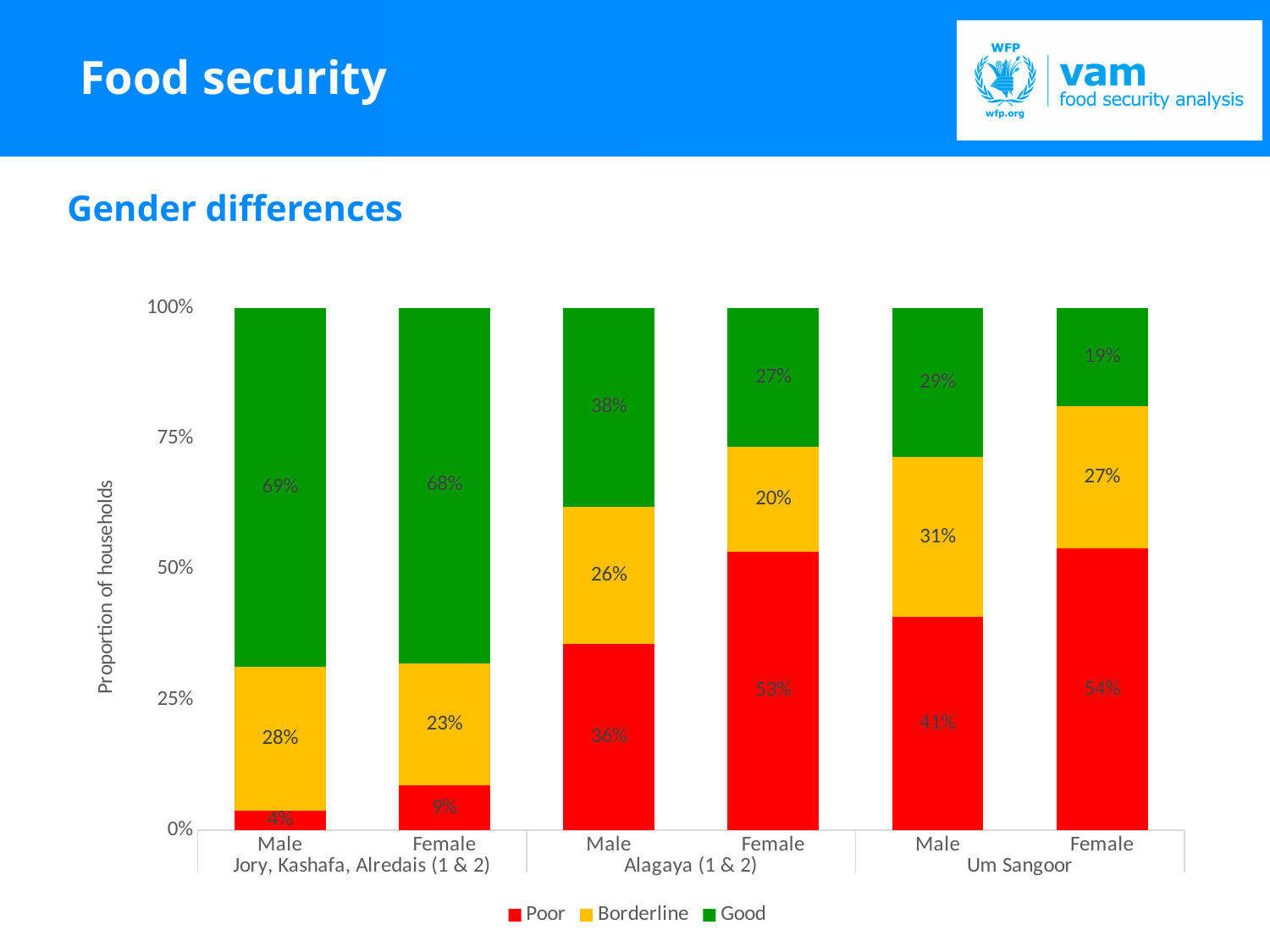
Which is larger: the Borderline share for Male households in Um Sangoor or for Female households in Um Sangoor? Male, Um Sangoor What is the Poor share for Male households in Jory, Kashafa, Alredais (1 & 2)? 4% Which bar has the lowest Good share? Female, Um Sangoor What type of chart is shown on the slide? Stacked bar chart What is the Good share for Female households in Um Sangoor? 19% What is the Borderline share for Male households in Alagaya (1 & 2)? 26% How many bars are plotted in the chart? 6 Which colour represents the Good series in the legend? Green What is the label of the vertical axis? Proportion of households Which bar has the highest Poor share? Female, Um Sangoor How many series does the legend list? 3 What is the difference between the Poor share for Female and Male households in Alagaya (1 & 2)? 17%